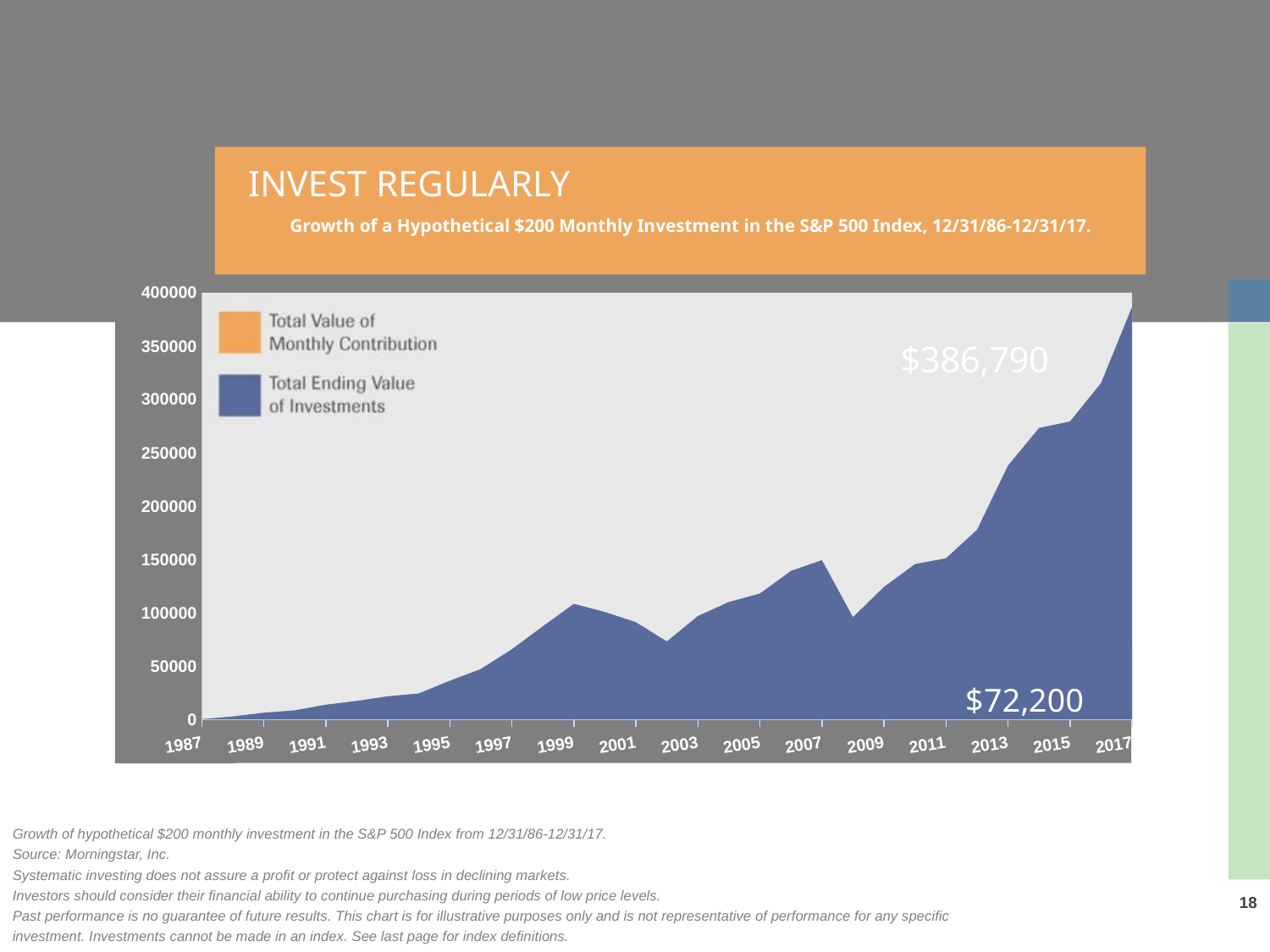
Overall, does the total ending value of investments rise or fall from 1987 to 2017? Rise Which is larger, the total ending value of investments or the total value of monthly contributions? Total ending value of investments Is the total ending value of investments in 1995 greater or less than 50000? less What is the difference between the total ending value of investments and the total value of monthly contributions? $314,590 What is the subtitle of the chart? Growth of a Hypothetical $200 Monthly Investment in the S&P 500 Index, 12/31/86-12/31/17. What is the total value of monthly contributions shown on the chart? $72,200 How many series does the chart legend list? 2 What kind of chart is shown on the slide? Area chart Is the total ending value of investments in 2015 greater or less than 250000? greater What is the total ending value of investments shown on the chart? $386,790 How many year labels are shown on the x axis? 16